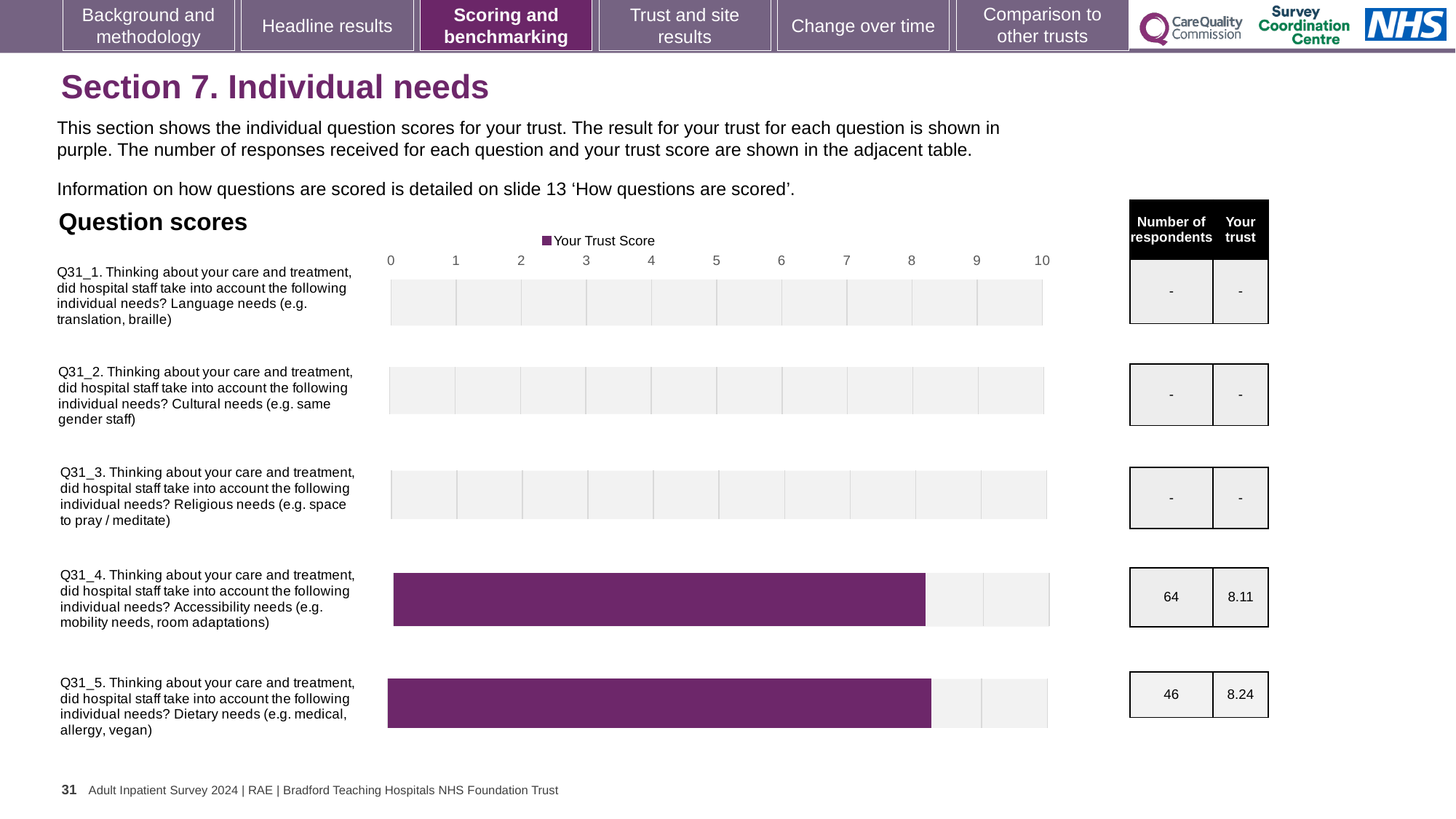
How many respondents answered Q31_4 (Accessibility needs)? 64 What is the trust score for Q31_5 (Dietary needs)? 8.24 What is the difference between the trust scores for Q31_5 and Q31_4? 0.13 Is the trust score for Q31_4 (Accessibility needs) greater or less than 9? less How many questions are listed in the Question scores chart? 5 How many respondents answered Q31_5 (Dietary needs)? 46 What is the trust score for Q31_4 (Accessibility needs)? 8.11 What is the maximum value shown on the chart's axis? 10 Is the trust score for Q31_5 (Dietary needs) greater or less than 8? greater Which question has the higher trust score, Q31_4 or Q31_5? Q31_5 What type of chart is used to show the question scores? Bar chart How many series does the chart legend list? 1